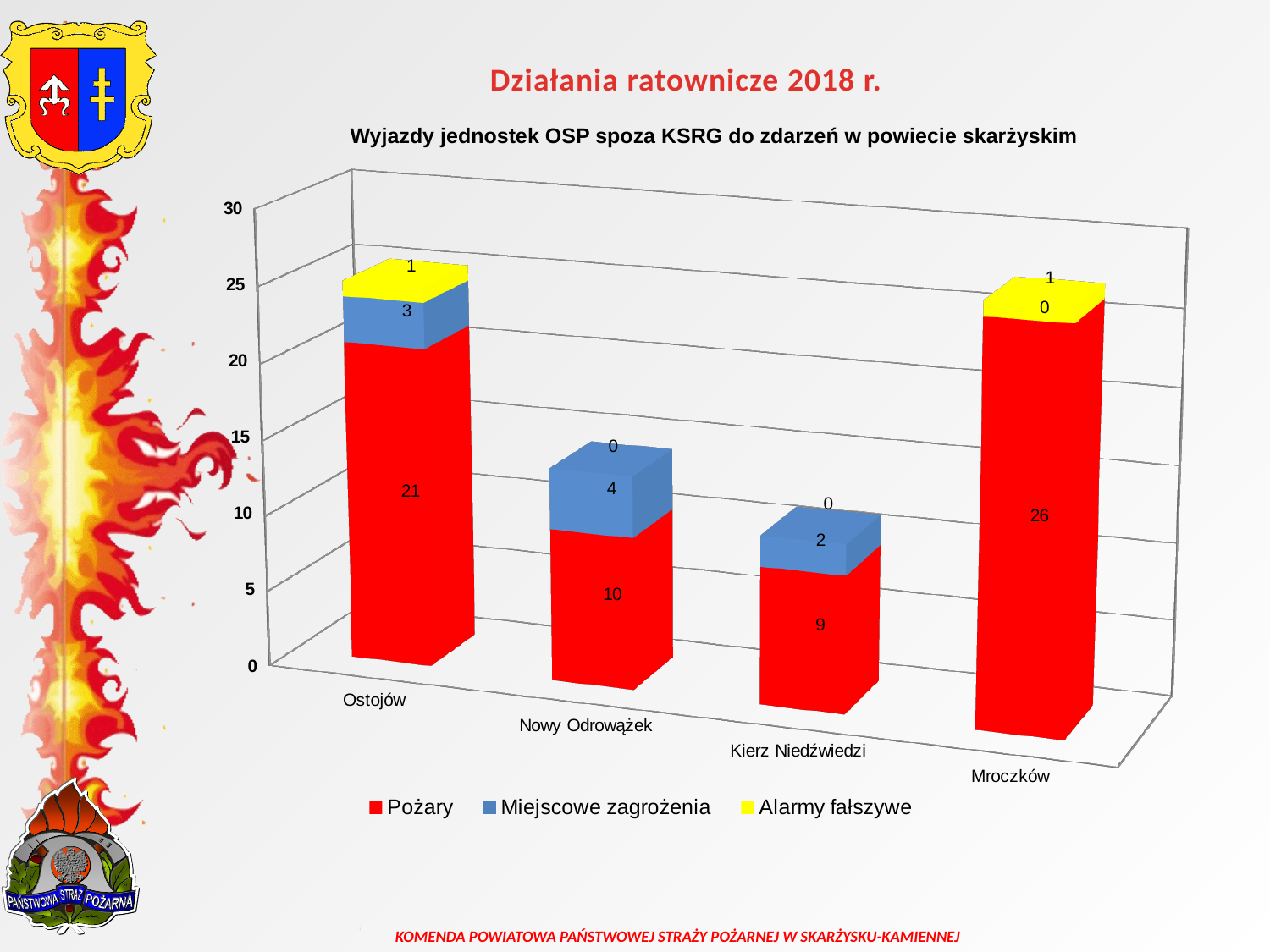
Which is larger, the Miejscowe zagrożenia value for Nowy Odrowążek or for Kierz Niedźwiedzi? Nowy Odrowążek What is the title of the chart? Wyjazdy jednostek OSP spoza KSRG do zdarzeń w powiecie skarżyskim What is the Alarmy fałszywe value for Mroczków? 1 What is the Miejscowe zagrożenia value for Nowy Odrowążek? 4 What is the total of the stacked bar for Ostojów? 25 What is the Pożary value for Ostojów? 21 Which category has the highest Pożary value? Mroczków What is the difference between the Pożary values for Mroczków and Ostojów? 5 How many series does the legend list? 3 Which category has the lowest Pożary value? Kierz Niedźwiedzi How many categories are shown on the x axis? 4 What kind of chart is shown on the slide? Stacked bar chart